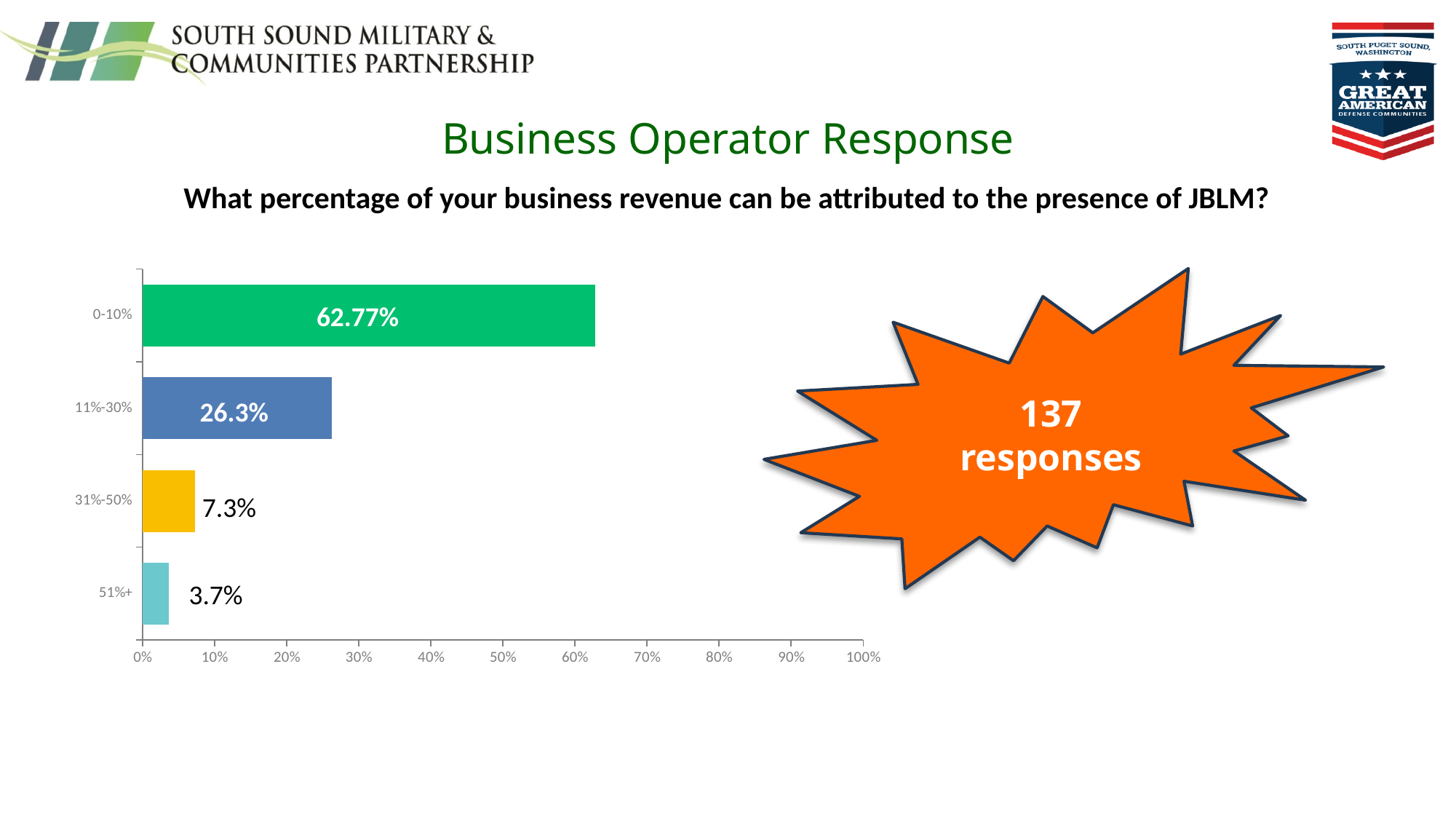
What value is shown for the 51%+ category? 3.7% What value is shown for the 11%-30% category? 26.3% Which category has the lowest value? 51%+ What percentage of respondents attributed 0-10% of their business revenue to the presence of JBLM? 62.77% What is the difference between the values for 11%-30% and 31%-50%? 19% How many categories are shown in the bar chart? 4 Is the value for 0-10% greater or less than 60%? greater Which is larger, the value for 31%-50% or the value for 51%+? 31%-50% What value is shown for the 31%-50% category? 7.3% Which category has the highest value? 0-10% What kind of chart is shown on the slide? bar chart How many responses does the slide say the survey received? 137 responses